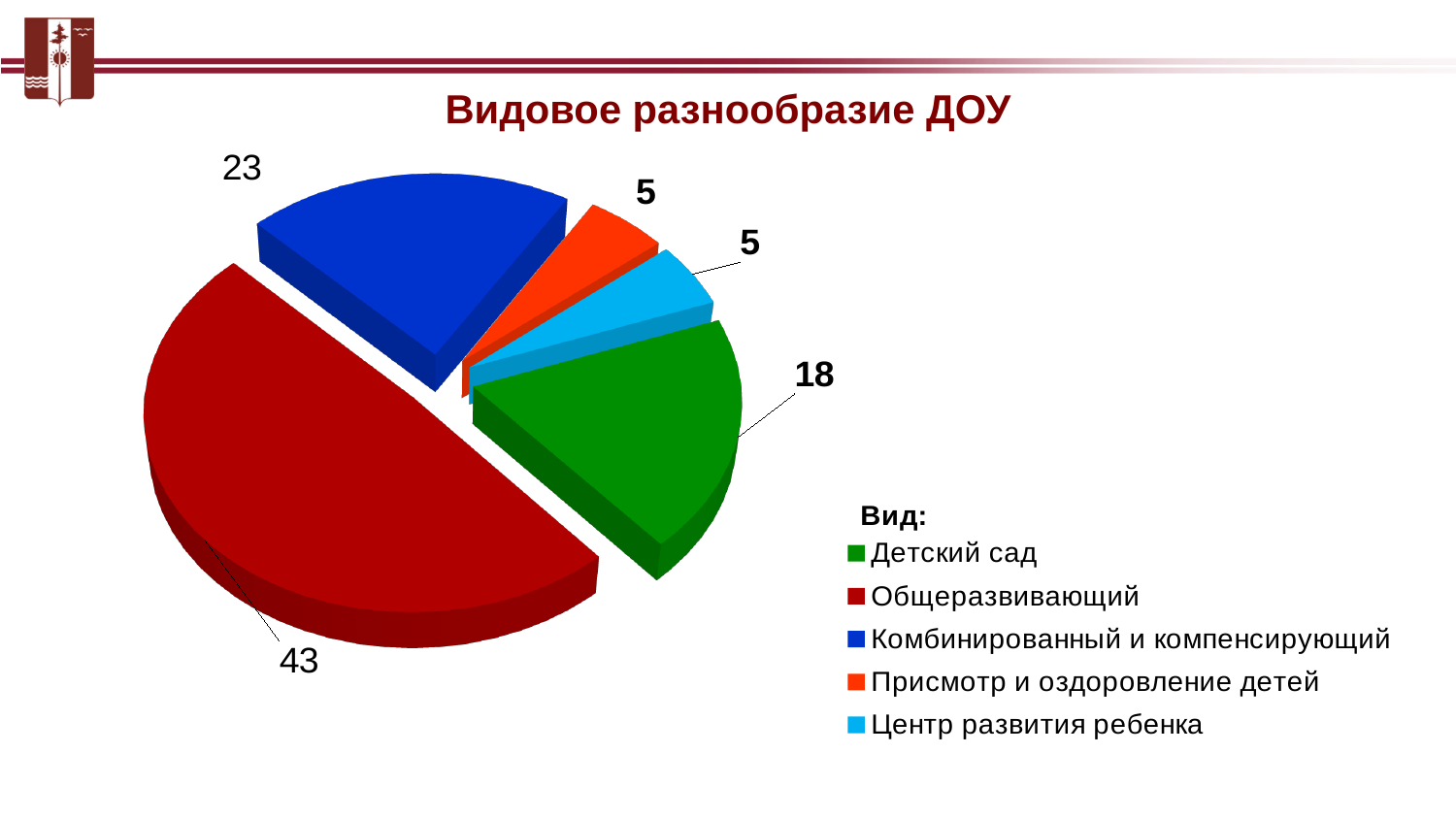
What is the difference between the values for Общеразвивающий and Комбинированный и компенсирующий? 20 Which category has the largest slice of the pie? Общеразвивающий What is the value for Общеразвивающий? 43 Which colour represents Присмотр и оздоровление детей in the legend? orange How many categories does the pie chart have? 5 What is the value for Комбинированный и компенсирующий? 23 What is the value for Центр развития ребенка? 5 Which is larger, the value for Детский сад or the value for Комбинированный и компенсирующий? Комбинированный и компенсирующий What is the total of all the values shown in the pie chart? 94 What is the title of the chart? Вид: What kind of chart is shown on the slide? pie chart What is the value for Детский сад? 18